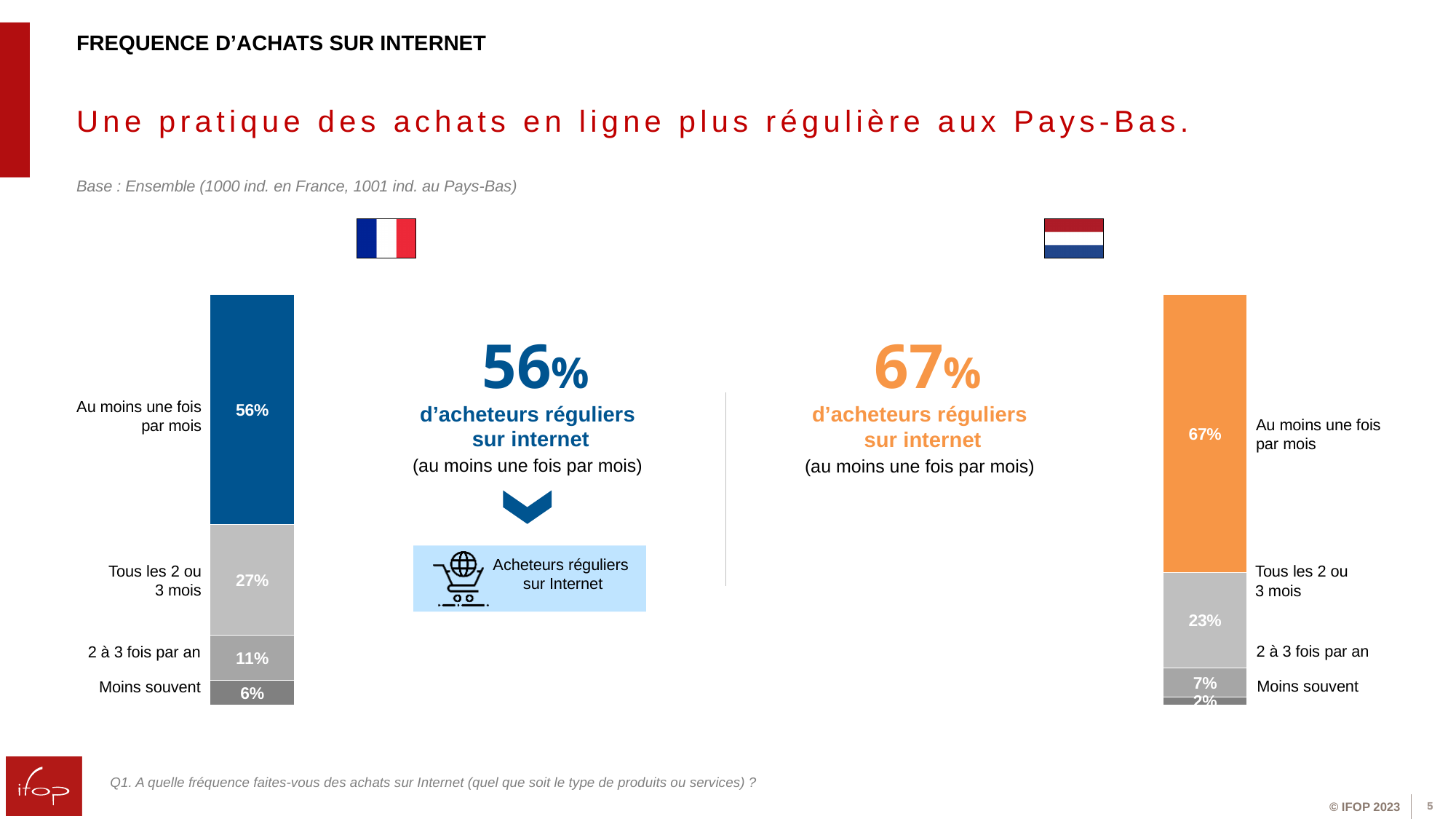
In the Netherlands chart on the right, which category has the highest value? Au moins une fois par mois In the France chart on the left, which category has the lowest value? Moins souvent Which is larger: the 'Tous les 2 ou 3 mois' value in the France chart or in the Netherlands chart? France How many categories are shown in the France chart on the left? 4 In the Netherlands chart on the right, what is the value for 'Tous les 2 ou 3 mois'? 23% What is the difference between the 'Au moins une fois par mois' values in the Netherlands chart and the France chart? 11 points In the France chart on the left, what percentage of respondents buy online at least once a month (Au moins une fois par mois)? 56% In the France chart on the left, what is the value for 'Tous les 2 ou 3 mois'? 27% In the Netherlands chart on the right, what percentage of respondents buy online at least once a month (Au moins une fois par mois)? 67% What type of chart is used to show the purchase frequency for each country? Stacked bar chart In the France chart on the left, what is the value for '2 à 3 fois par an'? 11% In the Netherlands chart on the right, what is the value for 'Moins souvent'? 2%